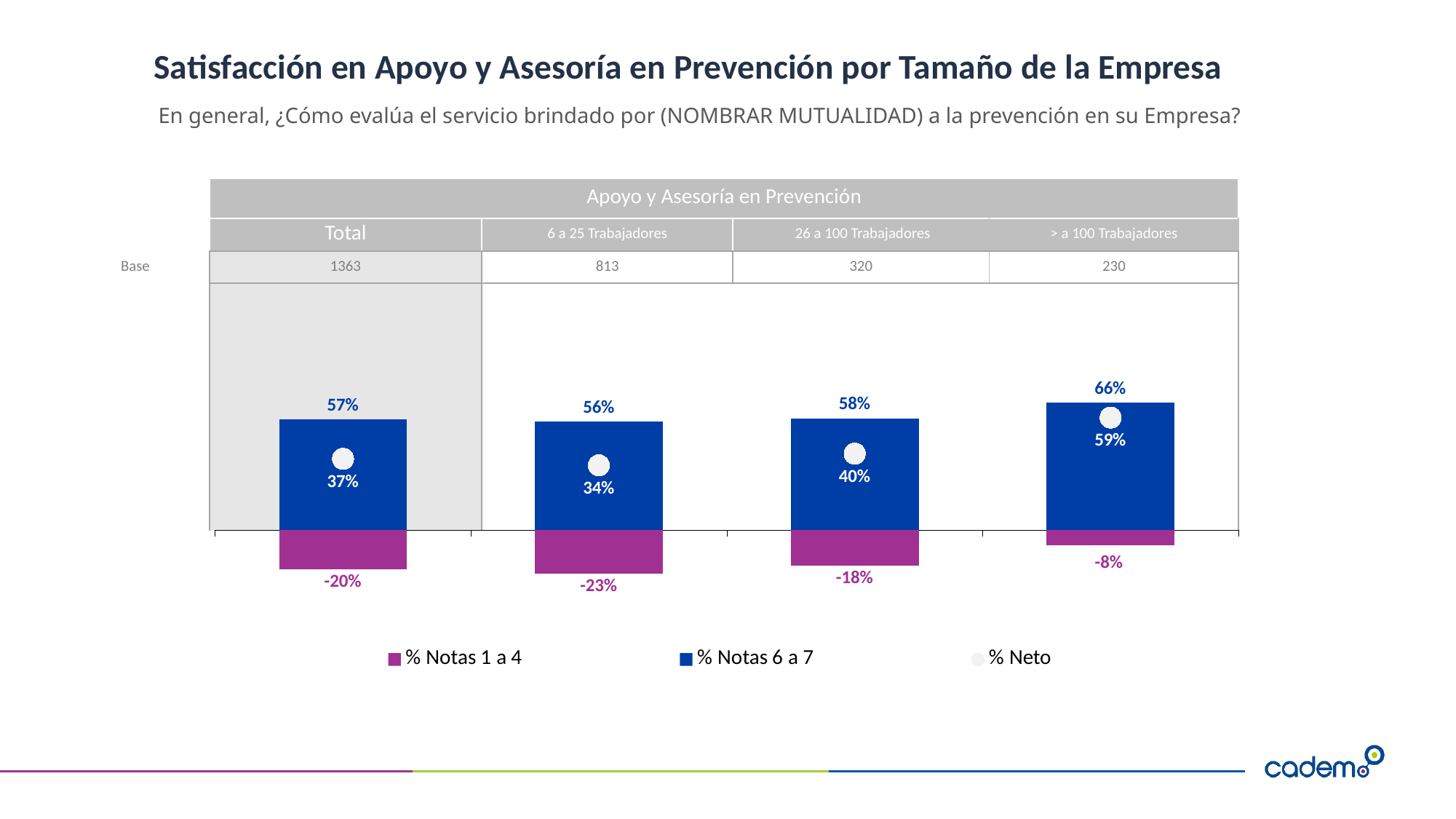
Which category has the lowest % Neto value? 6 a 25 Trabajadores What is the base (number of respondents) for 26 a 100 Trabajadores? 320 How many categories are shown on the x axis of the chart? 4 What is the difference between the % Notas 6 a 7 values for > a 100 Trabajadores and 6 a 25 Trabajadores? 10 percentage points Which is larger, the % Neto for 26 a 100 Trabajadores or the % Neto for Total? 26 a 100 Trabajadores What is the value of % Notas 1 a 4 for 6 a 25 Trabajadores? -23% How many series does the legend list? 3 What is the value of % Notas 6 a 7 for 26 a 100 Trabajadores? 58% What is the % Neto value for > a 100 Trabajadores? 59% What kind of chart is shown on the slide? Bar chart Which category has the highest % Notas 6 a 7 value? > a 100 Trabajadores What is the value of % Notas 6 a 7 for the Total category? 57%